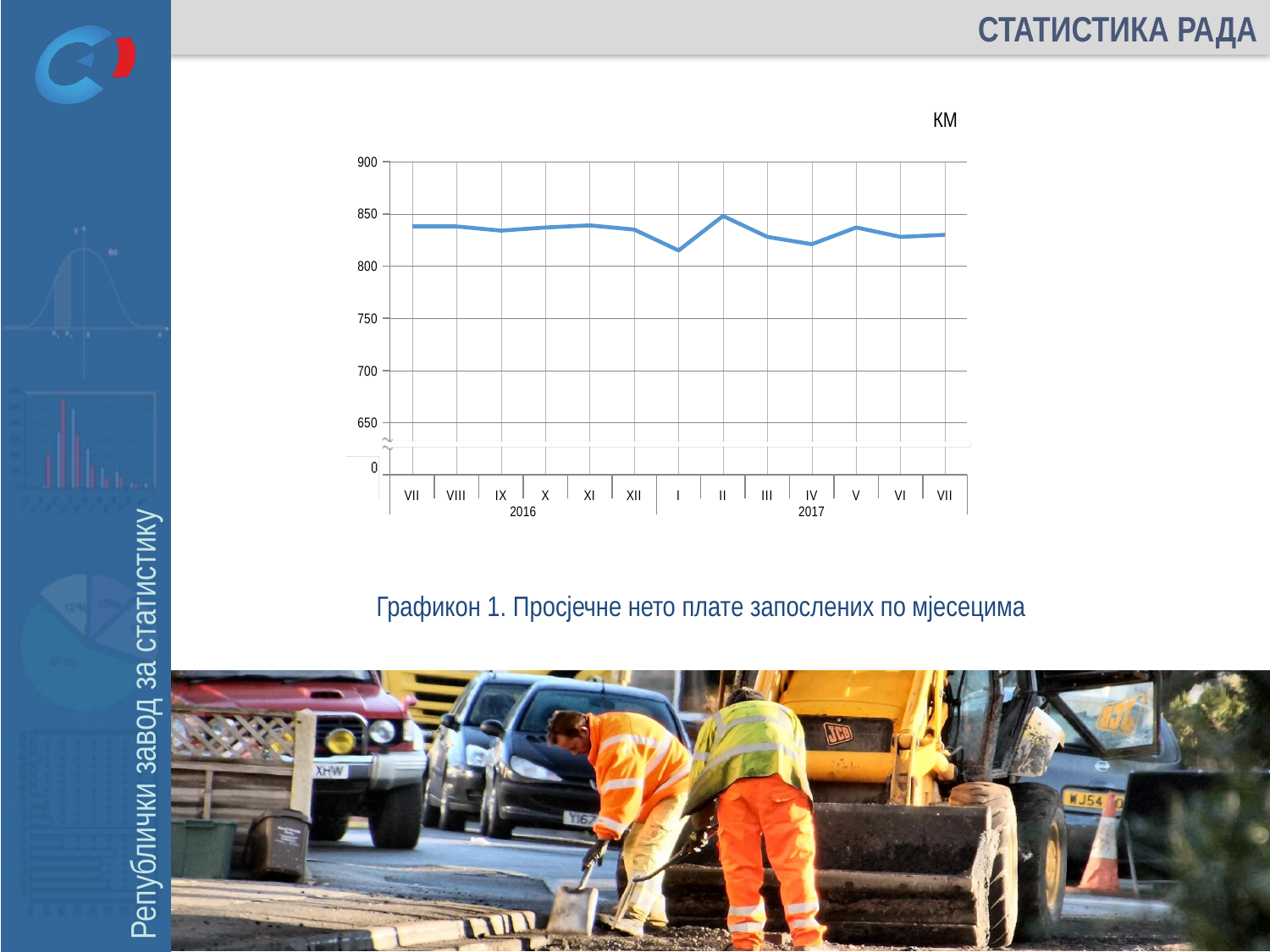
Is the value for I 2017 greater or less than 800? greater Which month has the highest average net wage on the chart? II 2017 What kind of chart is shown on the slide? line chart Does the line rise or fall from XII 2016 to I 2017? fall Which is larger, the value for II 2017 or the value for I 2017? II 2017 How many monthly data points are plotted on the chart? 13 Which is larger, the value for VII 2016 or the value for I 2017? VII 2016 What unit is shown above the chart's vertical axis? KM Is the value for VII 2016 greater or less than 850? less What is the caption of the chart on the slide? Графикон 1. Просјечне нето плате запослених по мјесецима Which month has the lowest average net wage on the chart? I 2017